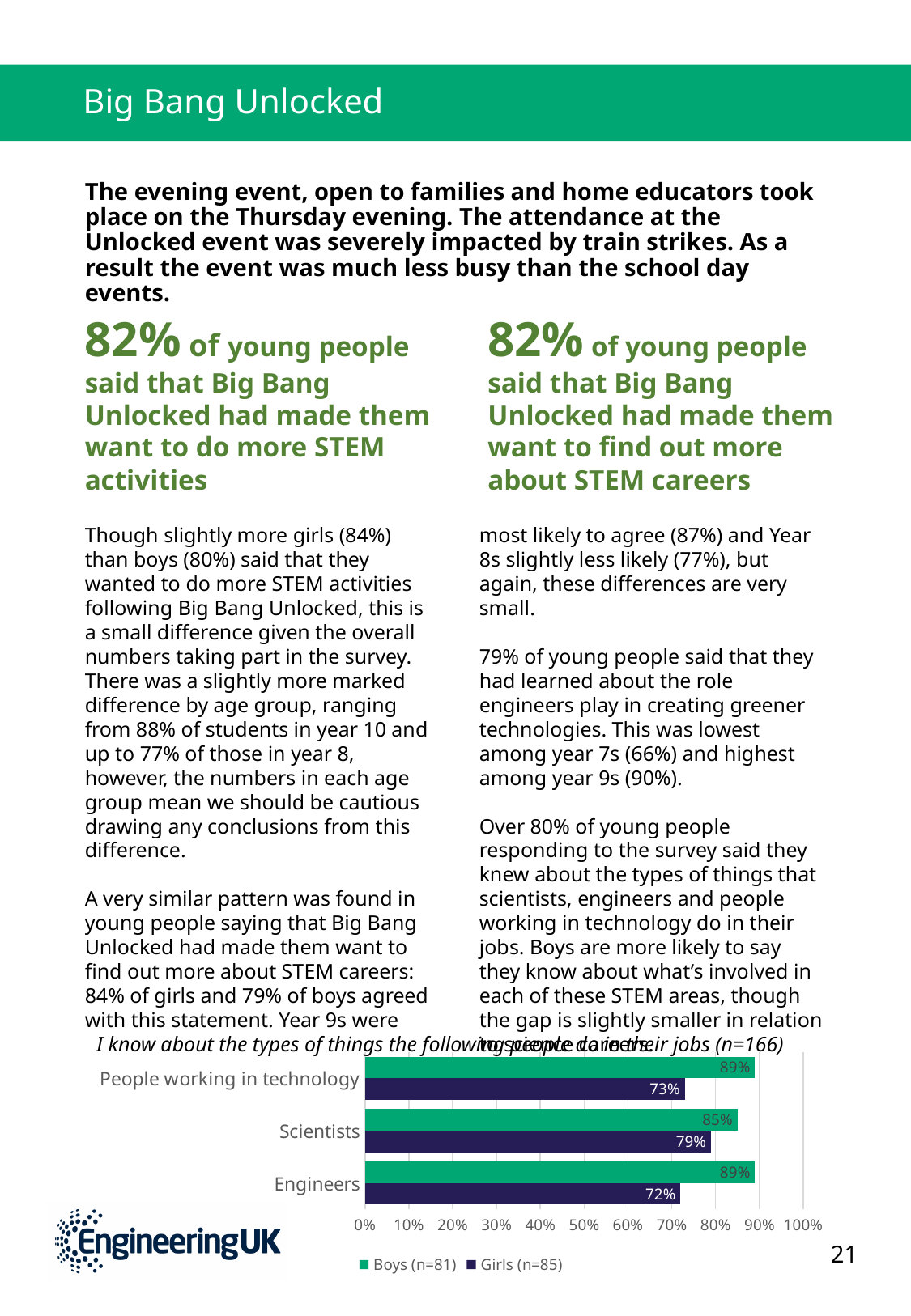
What percentage of girls said they know about the types of things scientists do in their jobs? 79% For which category is the Girls value lowest? Engineers What percentage of boys said they know about the types of things scientists do in their jobs? 85% Which is larger for Scientists, the Boys value or the Girls value? Boys What percentage of boys said they know about the types of things people working in technology do in their jobs? 89% What type of chart is shown on the slide? Bar chart How many categories are shown on the chart? 3 What is the difference between the Boys and Girls values for People working in technology? 16% What percentage of girls said they know about the types of things engineers do in their jobs? 72% How many series does the chart legend list? 2 What is the difference between the Boys and Girls values for Engineers? 17% For which category is the Girls value highest? Scientists